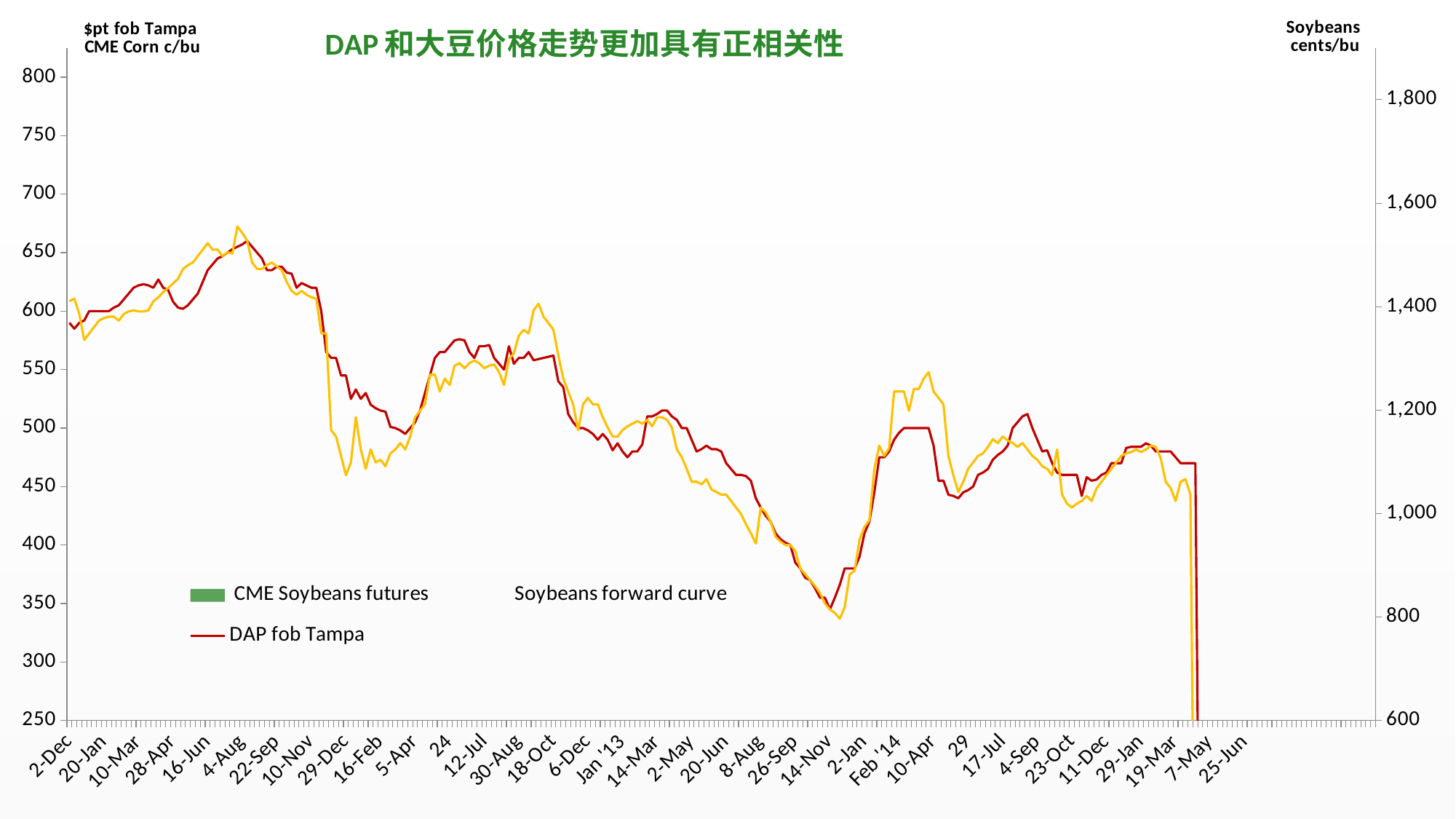
How many series does the legend list? 3 Around which x-axis date does the DAP fob Tampa line reach its highest point? 4-Aug What is the title of the chart? DAP 和大豆价格走势更加具有正相关性 What kind of chart is shown on the slide? Line chart Does the DAP fob Tampa line rise or fall between 14-Nov (2013) and Feb '14? Rise What colour is the DAP fob Tampa line? Red Is the DAP fob Tampa value around 14-Nov (2013) greater or less than 400? less Is the DAP fob Tampa value around 29-Jan (2015) greater or less than 450? greater